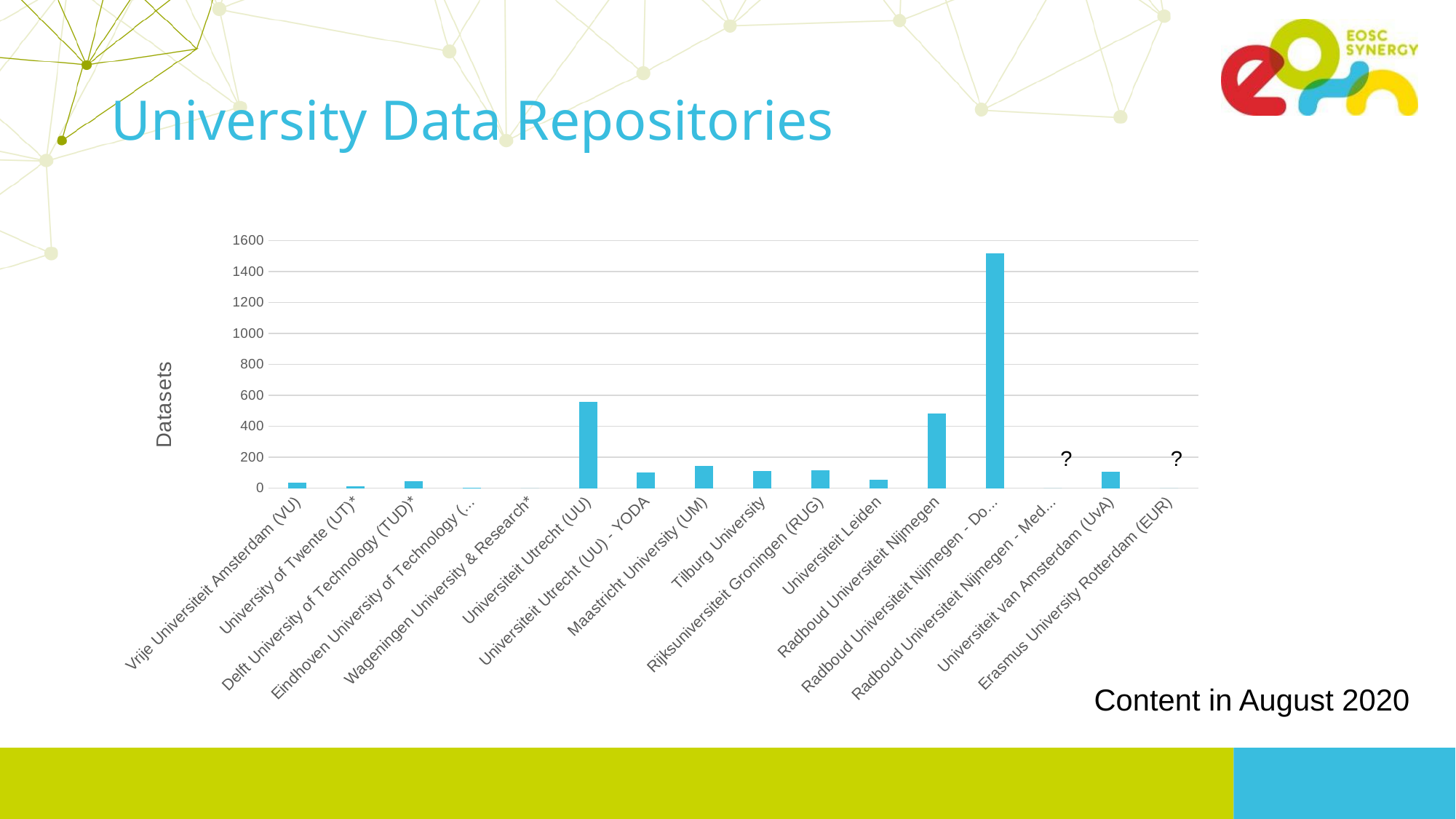
What is the title of the slide containing the chart? University Data Repositories Which has more datasets, Universiteit Utrecht (UU) or Radboud Universiteit Nijmegen? Universiteit Utrecht (UU) Is the value for Universiteit Utrecht (UU) greater or less than 400? greater Which university has the highest number of datasets in the chart? Radboud Universiteit Nijmegen - Do... Is the value for Radboud Universiteit Nijmegen - Do... greater or less than 1400? greater What is the label of the vertical axis? Datasets Is the value for Maastricht University (UM) greater or less than 200? less Which has more datasets, Radboud Universiteit Nijmegen - Do... or Universiteit Utrecht (UU)? Radboud Universiteit Nijmegen - Do... What kind of chart is shown on the slide? bar chart